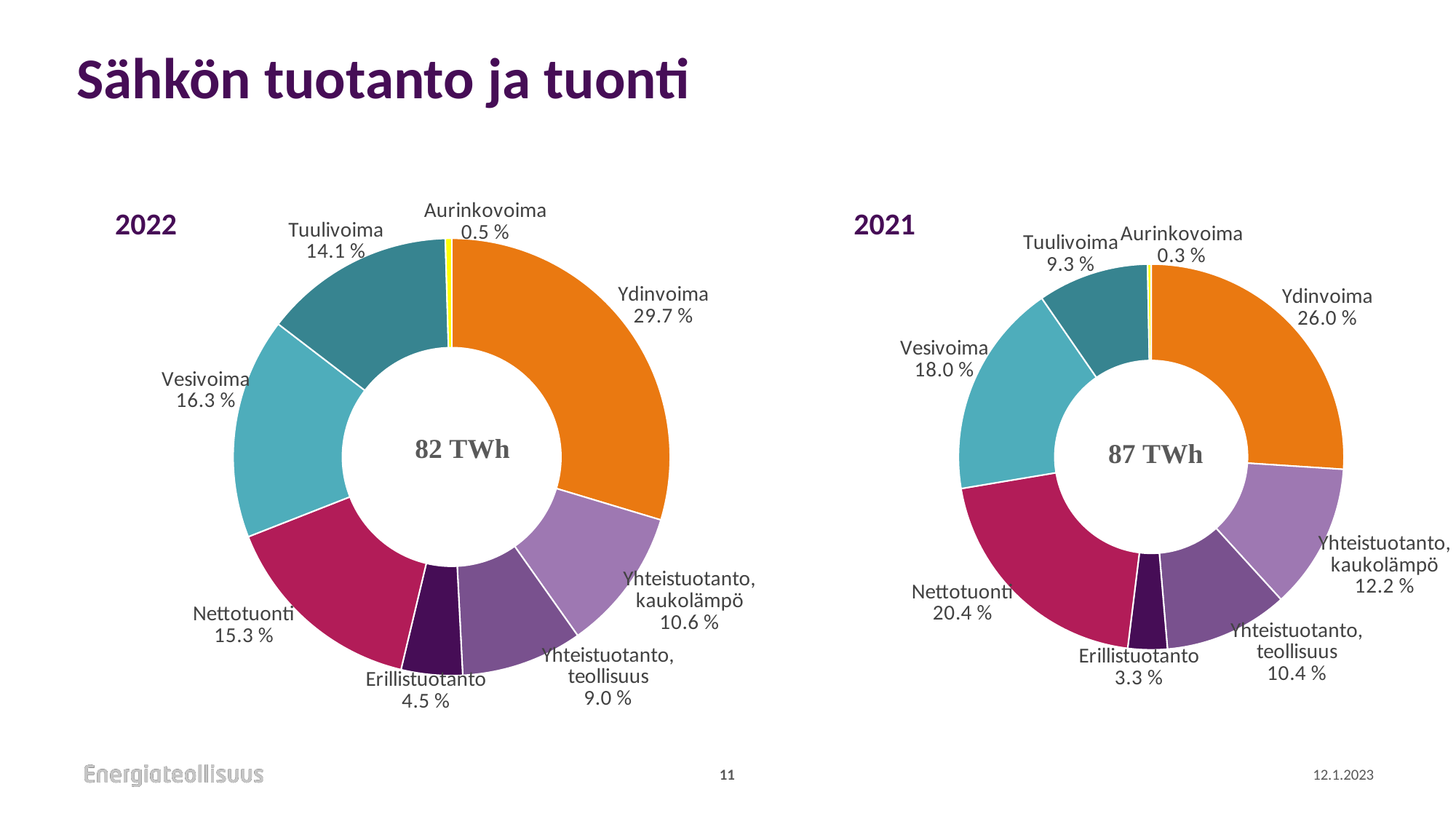
In the 2021 chart, which category has the smallest share? Aurinkovoima In the 2022 chart, what share does Ydinvoima have? 29.7 % In the 2021 chart, which is larger: the share of Vesivoima or the share of Tuulivoima? Vesivoima What is the title of the slide? Sähkön tuotanto ja tuonti In the 2022 chart, what share does Erillistuotanto have? 4.5 % In the 2022 chart, what is the difference between the shares of Vesivoima and Tuulivoima? 2.2 % How many categories does the 2022 chart show? 8 In the 2021 chart, what share does Yhteistuotanto, kaukolämpö have? 12.2 % What kind of chart is the 2021 chart? Doughnut chart What total is shown in the centre of the 2022 chart? 82 TWh In the 2022 chart, which category has the largest share? Ydinvoima In the 2021 chart, what share does Nettotuonti have? 20.4 %